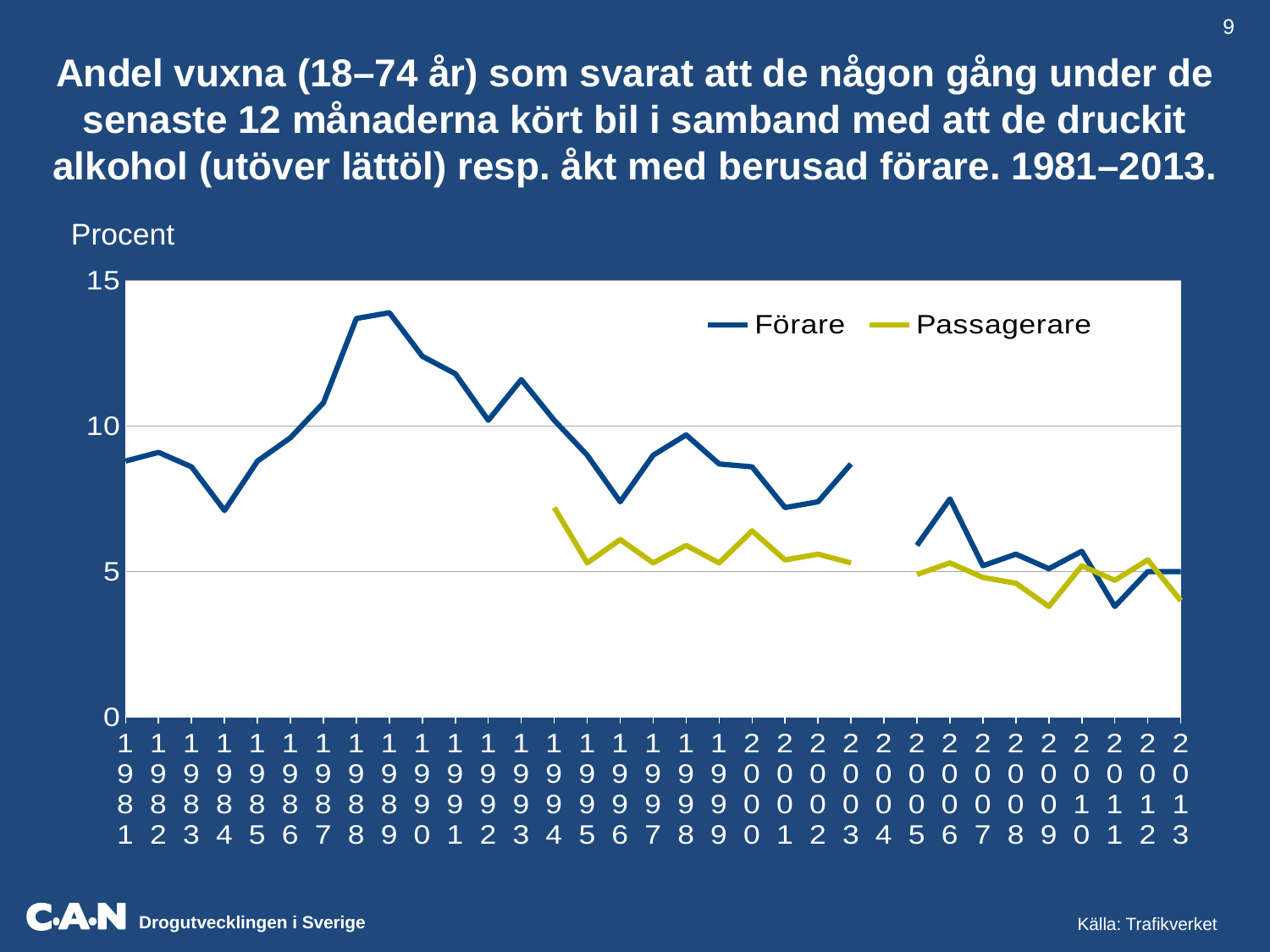
In which year does the Passagerare series reach its highest value? 1994 How many years are labelled along the x axis? 33 What are the two series named in the legend? Förare and Passagerare Which series has the larger value in 1994, Förare or Passagerare? Förare How many series does the legend list? 2 In which year does the Förare series reach its highest value? 1989 Is the value for Förare in 2011 greater or less than 5? less What kind of chart is shown on the slide? Line chart Is the value for Passagerare in 1994 greater or less than 5? greater What is the label shown above the y axis? Procent Is the value for Förare in 1989 greater or less than 10? greater In which year does the Förare series reach its lowest value? 2011